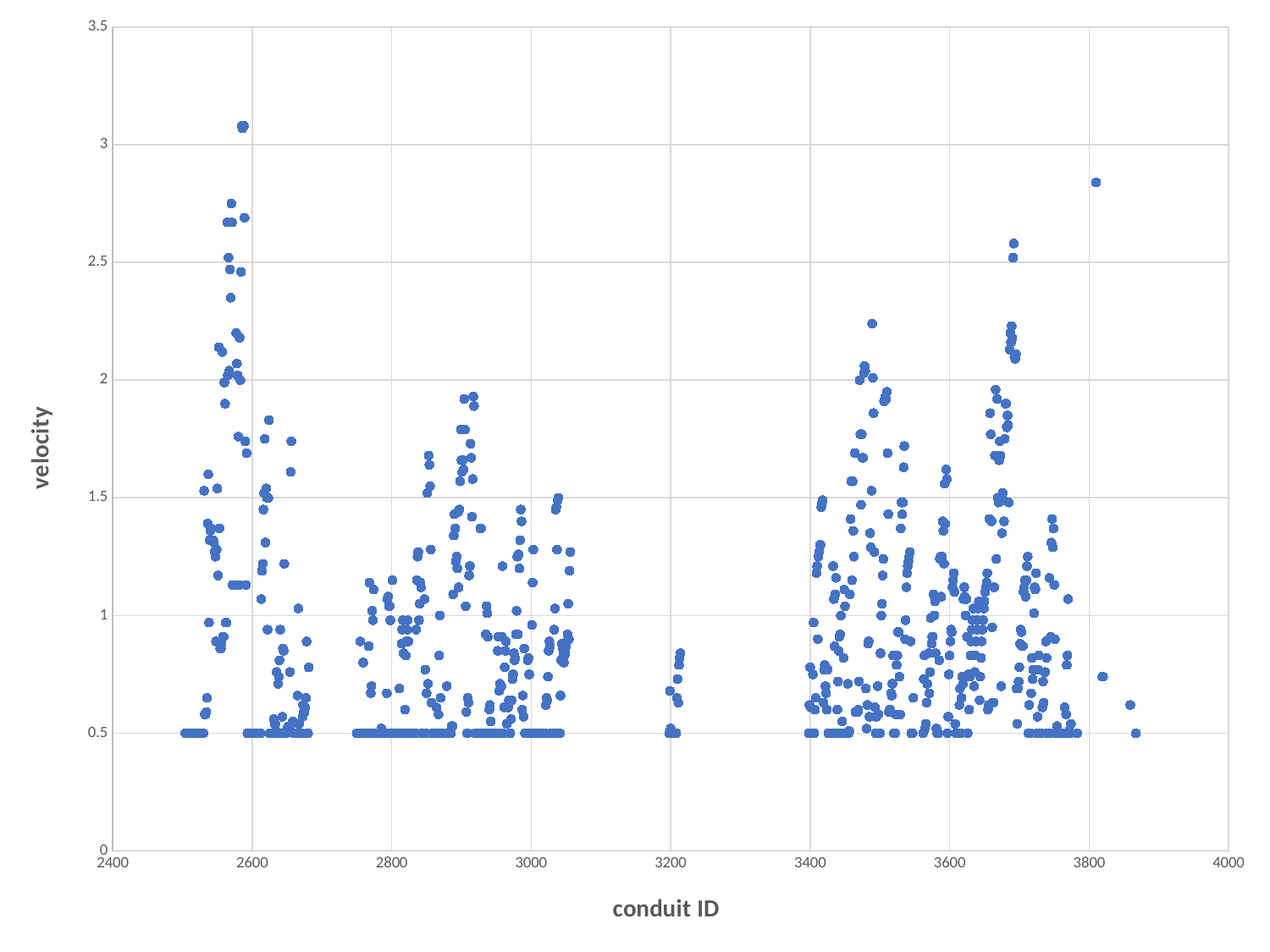
Is the highest velocity plotted for conduit IDs between 3200 and 3400 greater or less than 1? less Is the highest velocity plotted for conduit IDs between 3400 and 3600 greater or less than 2? greater What kind of chart is shown on the slide? scatter plot Is the highest velocity plotted for conduit IDs between 3800 and 4000 greater or less than 2.5? greater What is the label of the y axis? velocity What is the label of the x axis? conduit ID